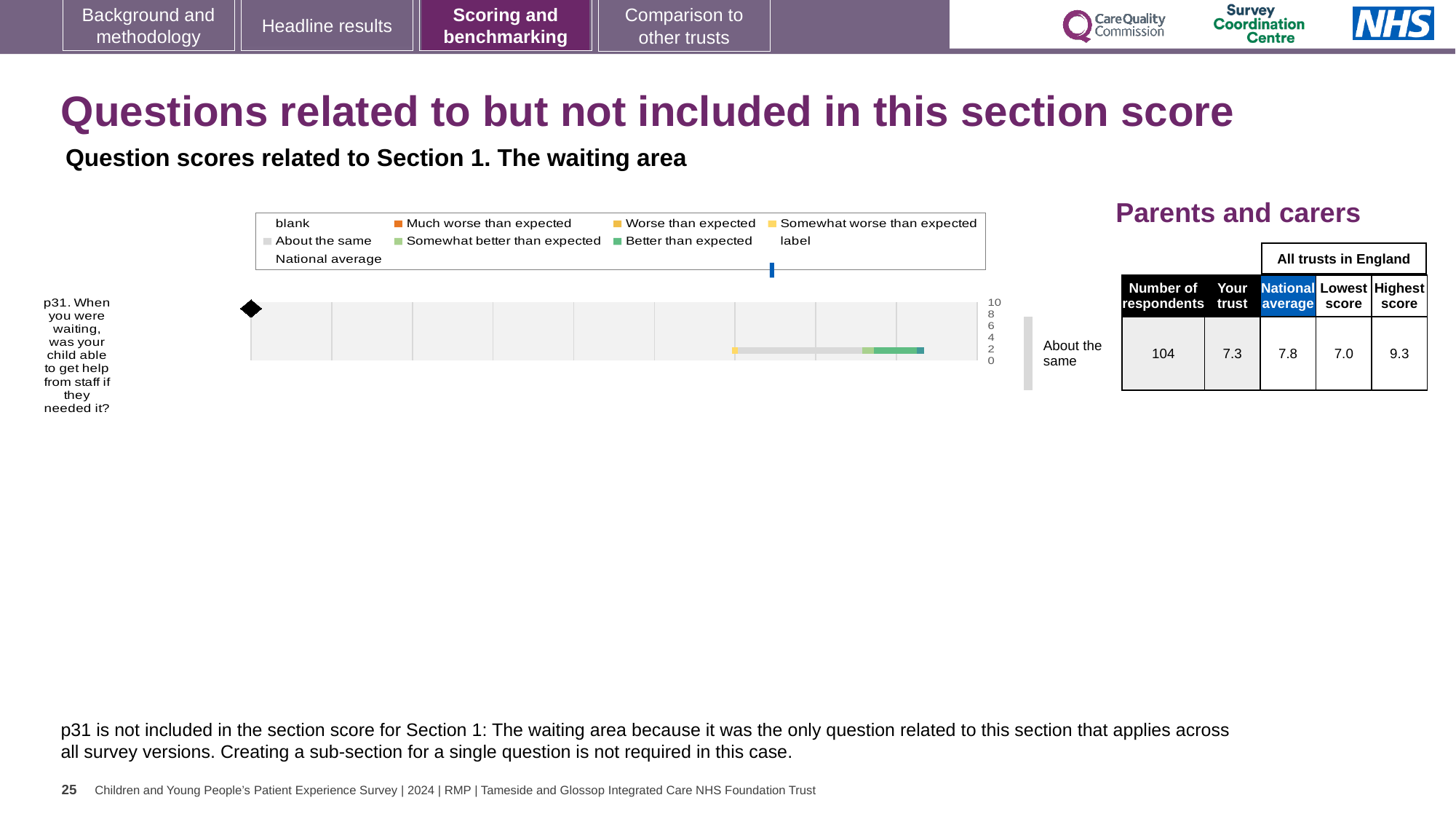
How many survey questions are plotted in the chart? 1 What is the lowest score among all trusts in England for p31? 7.0 What is the 'Your trust' score for p31? 7.3 Which survey question is plotted in the chart? p31. When you were waiting, was your child able to get help from staff if they needed it? What is the difference between the national average and the trust's score for p31? 0.5 What is the difference between the highest and lowest scores for p31? 2.3 What kind of chart is shown on the slide? bar chart Which benchmarking category is the trust's p31 score placed in? About the same What is the highest score among all trusts in England for p31? 9.3 How many respondents answered p31? 104 Which is larger for p31, the trust's score or the national average? National average What is the national average score for p31? 7.8